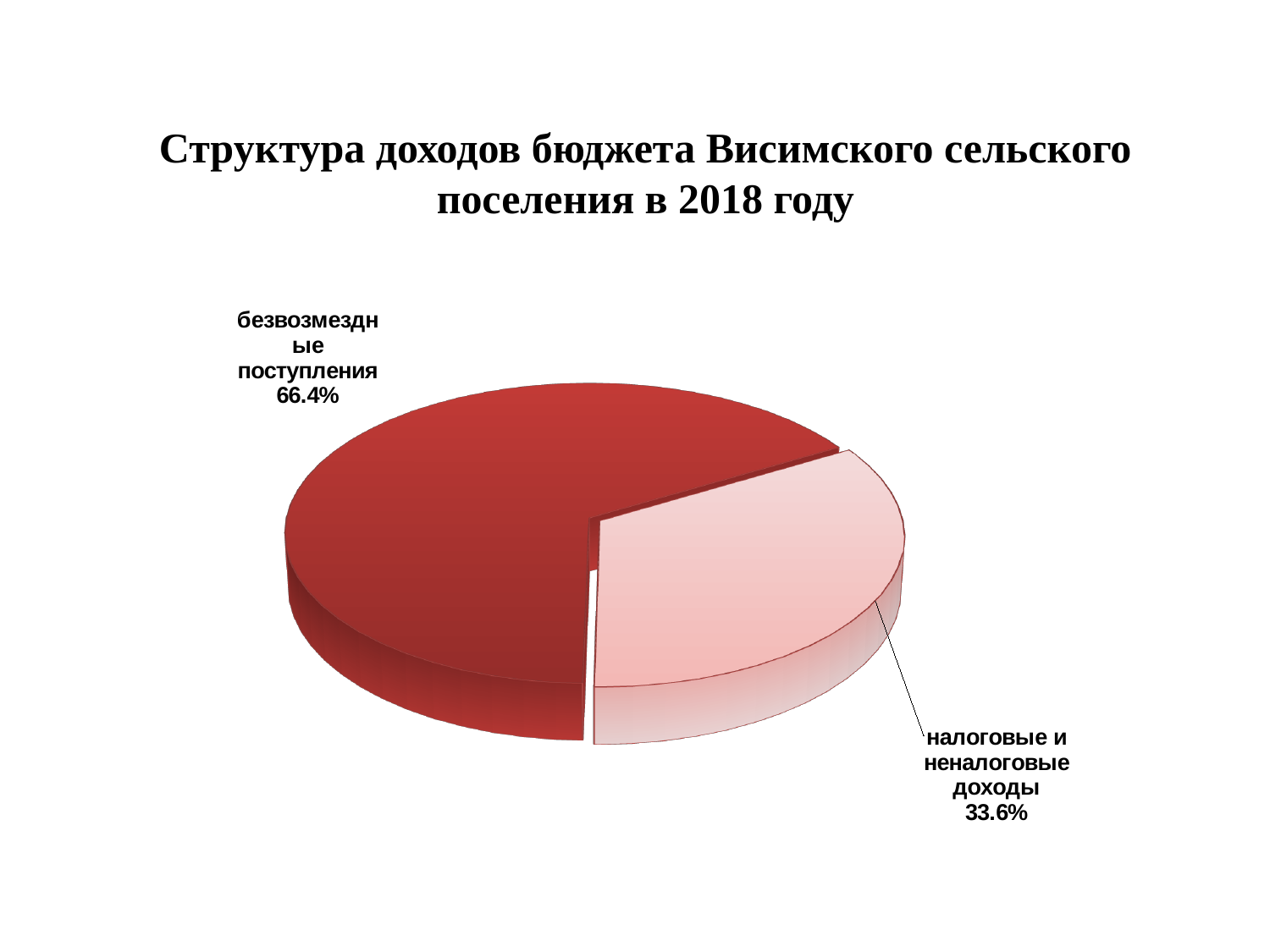
What share of the pie does безвозмездные поступления have? 66.4% What share of the pie does налоговые и неналоговые доходы have? 33.6% What kind of chart is shown on the slide? pie chart Is the share for налоговые и неналоговые доходы greater or less than 50%? less What is the title of the chart on the slide? Структура доходов бюджета Висимского сельского поселения в 2018 году Which slice of the pie is the largest? безвозмездные поступления Which slice of the pie is the smallest? налоговые и неналоговые доходы How many slices does the pie chart have? 2 Which slice is shown in the lighter pink colour? налоговые и неналоговые доходы Which is larger: безвозмездные поступления or налоговые и неналоговые доходы? безвозмездные поступления What is the difference in percentage points between безвозмездные поступления and налоговые и неналоговые доходы? 32.8 Is the share for безвозмездные поступления greater or less than 50%? greater